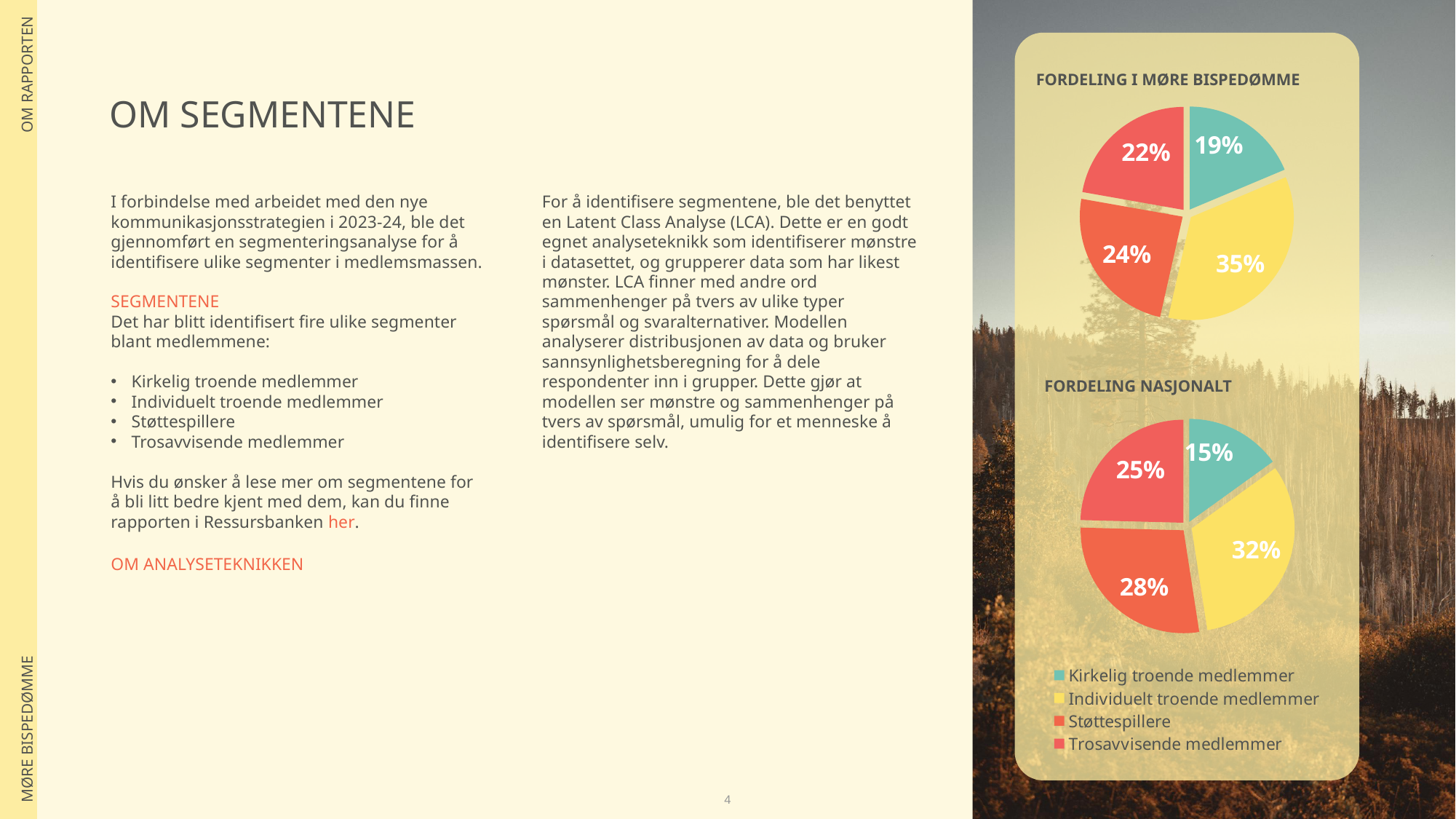
In the 'FORDELING I MØRE BISPEDØMME' pie chart, which segment has the largest slice? Individuelt troende medlemmer In the 'FORDELING NASJONALT' pie chart, which segment has the smallest slice? Kirkelig troende medlemmer In the 'FORDELING NASJONALT' pie chart, what share is shown for Kirkelig troende medlemmer? 15% In the 'FORDELING NASJONALT' pie chart, what share is shown for Individuelt troende medlemmer? 32% What is the title of the upper pie chart on the slide? FORDELING I MØRE BISPEDØMME In the 'FORDELING I MØRE BISPEDØMME' pie chart, how many percentage points larger is the Individuelt troende medlemmer slice than the Kirkelig troende medlemmer slice? 16 percentage points In the 'FORDELING I MØRE BISPEDØMME' pie chart, what share is shown for Individuelt troende medlemmer? 35% What type of chart is used for 'FORDELING I MØRE BISPEDØMME'? Pie chart In the 'FORDELING I MØRE BISPEDØMME' pie chart, what share is shown for Kirkelig troende medlemmer? 19% How many entries does the legend below the pie charts list? 4 How many slices does the 'FORDELING NASJONALT' pie chart have? 4 Is the share of Kirkelig troende medlemmer larger in the 'FORDELING I MØRE BISPEDØMME' chart or in the 'FORDELING NASJONALT' chart? FORDELING I MØRE BISPEDØMME